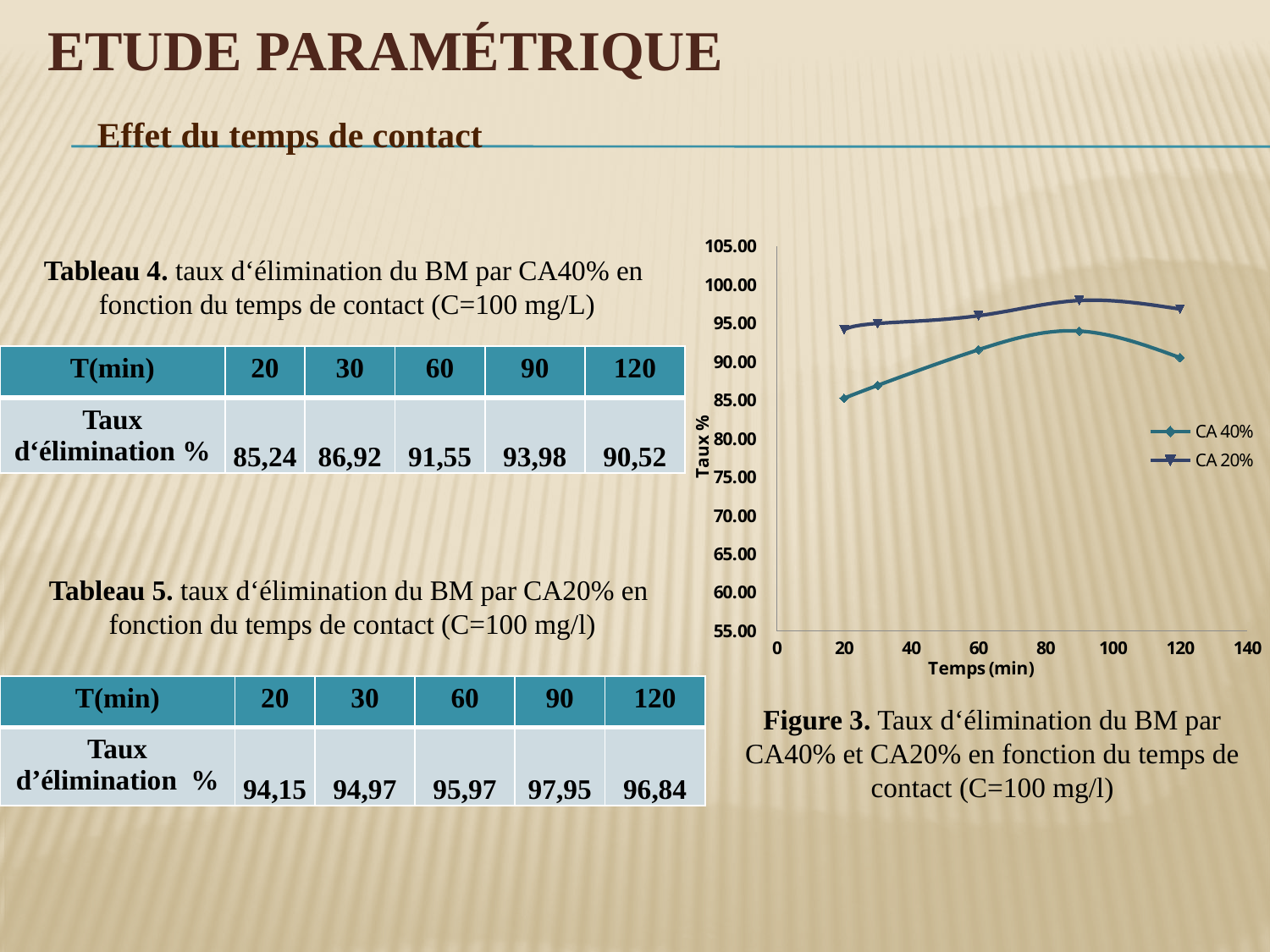
How many series does the legend of the Figure 3 chart list? 2 In the Figure 3 chart, which series has the higher values at every contact time, CA 40% or CA 20%? CA 20% In the Figure 3 chart, at which contact time is the CA 20% series lowest? 20 What is the label of the x axis of the Figure 3 chart? Temps (min) What are the two series named in the legend of the Figure 3 chart? CA 40% and CA 20% How many data points are plotted for the CA 40% series in the Figure 3 chart? 5 In the Figure 3 chart, at which contact time does the CA 40% series reach its highest value? 90 In the Figure 3 chart, does the CA 40% series rise or fall between 20 min and 90 min? rise What kind of chart is shown in Figure 3? line chart In the Figure 3 chart, is the value for CA 20% at 90 min greater or less than 95.00? greater In the Figure 3 chart, is the value for CA 40% at 20 min greater or less than 90.00? less